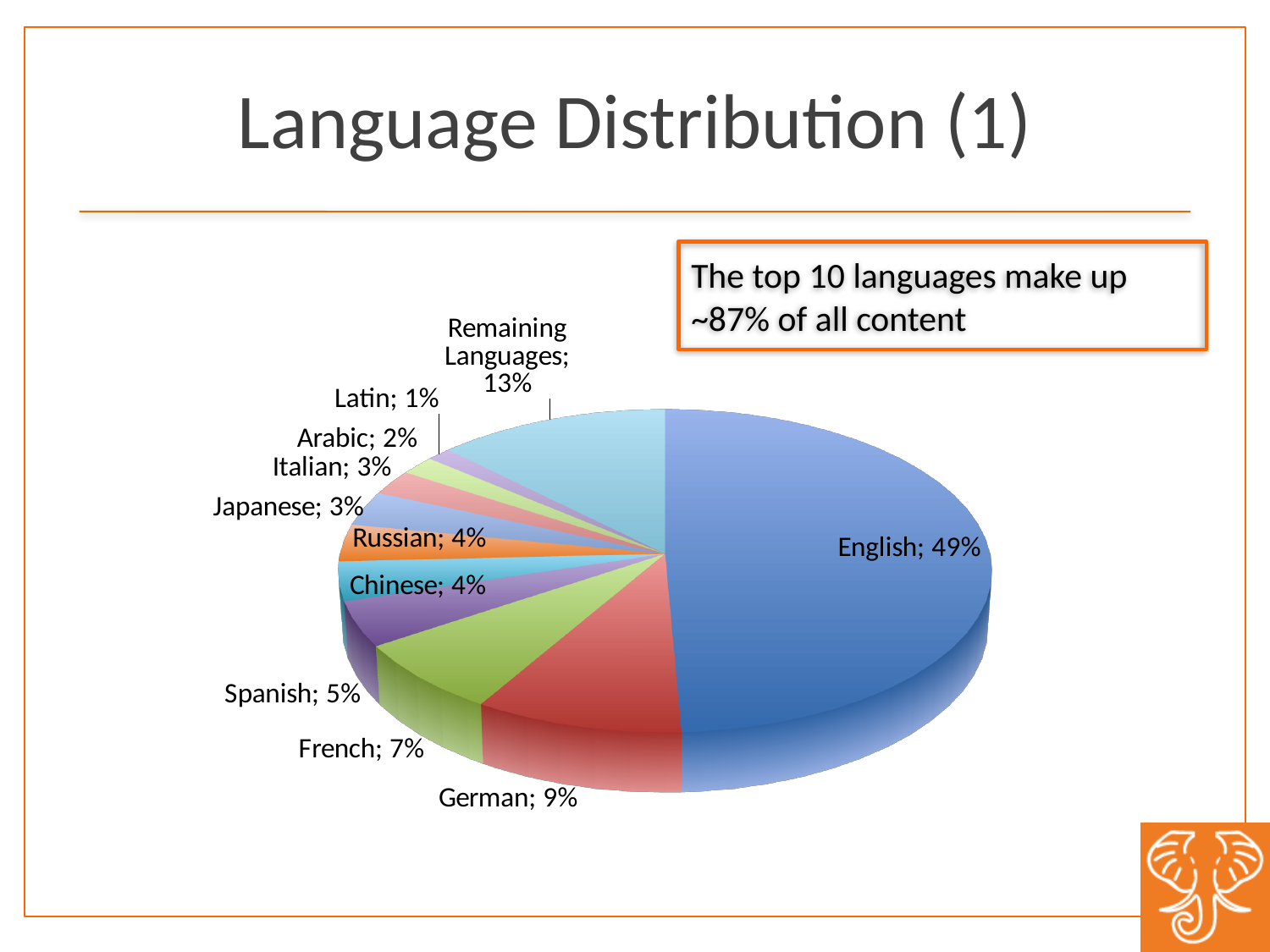
What kind of chart is shown on the slide? pie chart What share of content is French? 7% What share of content do the Remaining Languages make up? 13% What is the title of the slide containing the chart? Language Distribution (1) Which language has the largest slice of the pie? English How many slices does the pie chart have? 11 What is the difference between the English share and the German share? 40% Which named language has the smallest slice of the pie? Latin What is the combined share of French and Spanish? 12% Which is larger, the share for Spanish or the share for Arabic? Spanish What share of content is German? 9% What share of content is English? 49%